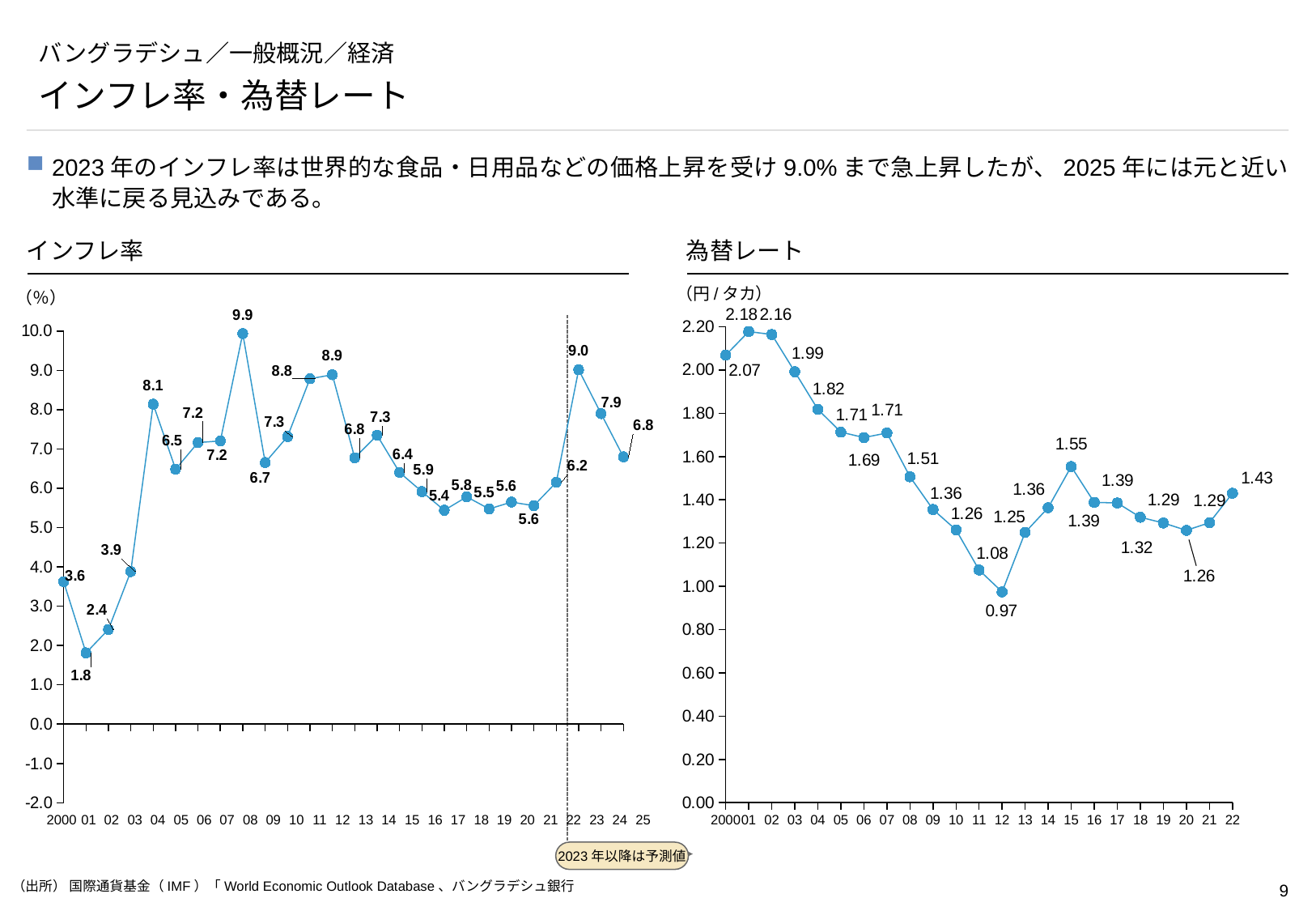
On the 為替レート chart, which year has the lowest value? 2012 On the 為替レート chart, what is the value for 2012? 0.97 On the 為替レート chart, which is larger, the value for 2015 or the value for 2022? 2015 On the インフレ率 chart, which year has the lowest inflation rate? 2001 On the インフレ率 chart, which year has the highest inflation rate? 2008 On the 為替レート chart, how many data points are plotted? 23 On the インフレ率 chart, what is the inflation rate for 2023? 9.0 On the 為替レート chart, which year has the highest value? 2001 On the インフレ率 chart, what is the difference between the 2023 value and the 2025 value? 2.2 On the 為替レート chart, do the values rise or fall from 2001 to 2012? fall On the 為替レート chart, what is the difference between the 2000 value and the 2022 value? 0.64 What kind of chart is the インフレ率 chart? line chart